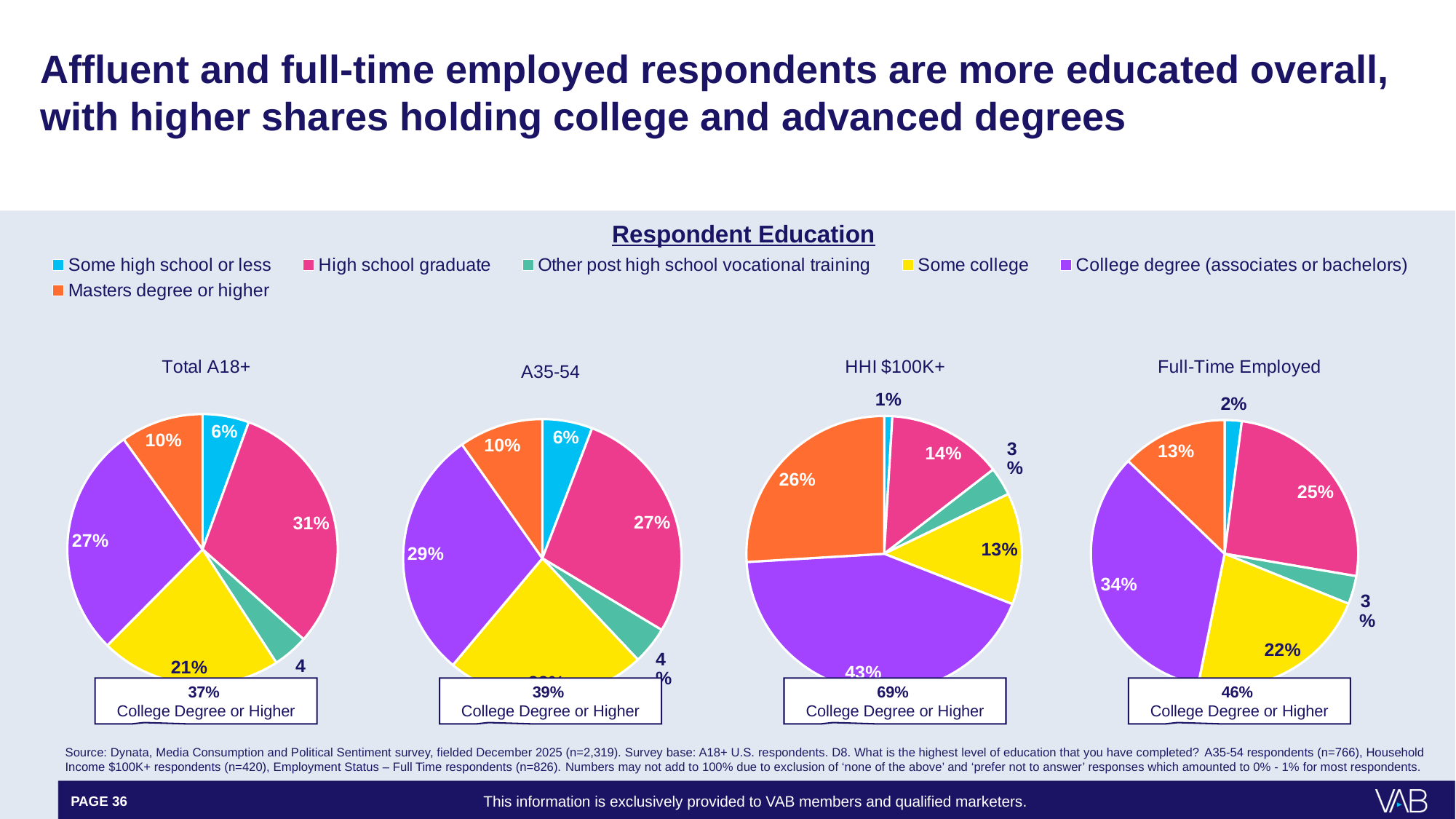
In the Full-Time Employed pie chart, which is larger: the share with a college degree (associates or bachelors) or the share who are high school graduates? College degree (associates or bachelors) In the Full-Time Employed pie chart, what share of respondents have a masters degree or higher? 13% What is the difference between the masters degree or higher share in the HHI $100K+ chart and in the Total A18+ chart? 16 percentage points In the HHI $100K+ pie chart, which education category has the largest share? College degree (associates or bachelors) In the A35-54 pie chart, what share of respondents have some high school or less? 6% In the HHI $100K+ pie chart, which education category has the smallest share? Some high school or less How many pie charts are shown on the slide? 4 In the Total A18+ pie chart, what share of respondents are high school graduates? 31% How many education categories does the legend list? 6 In the HHI $100K+ pie chart, what share of respondents hold a college degree (associates or bachelors)? 43% What type of chart is used to show respondent education on this slide? Pie chart According to the box below the Full-Time Employed pie chart, what share have a college degree or higher? 46%